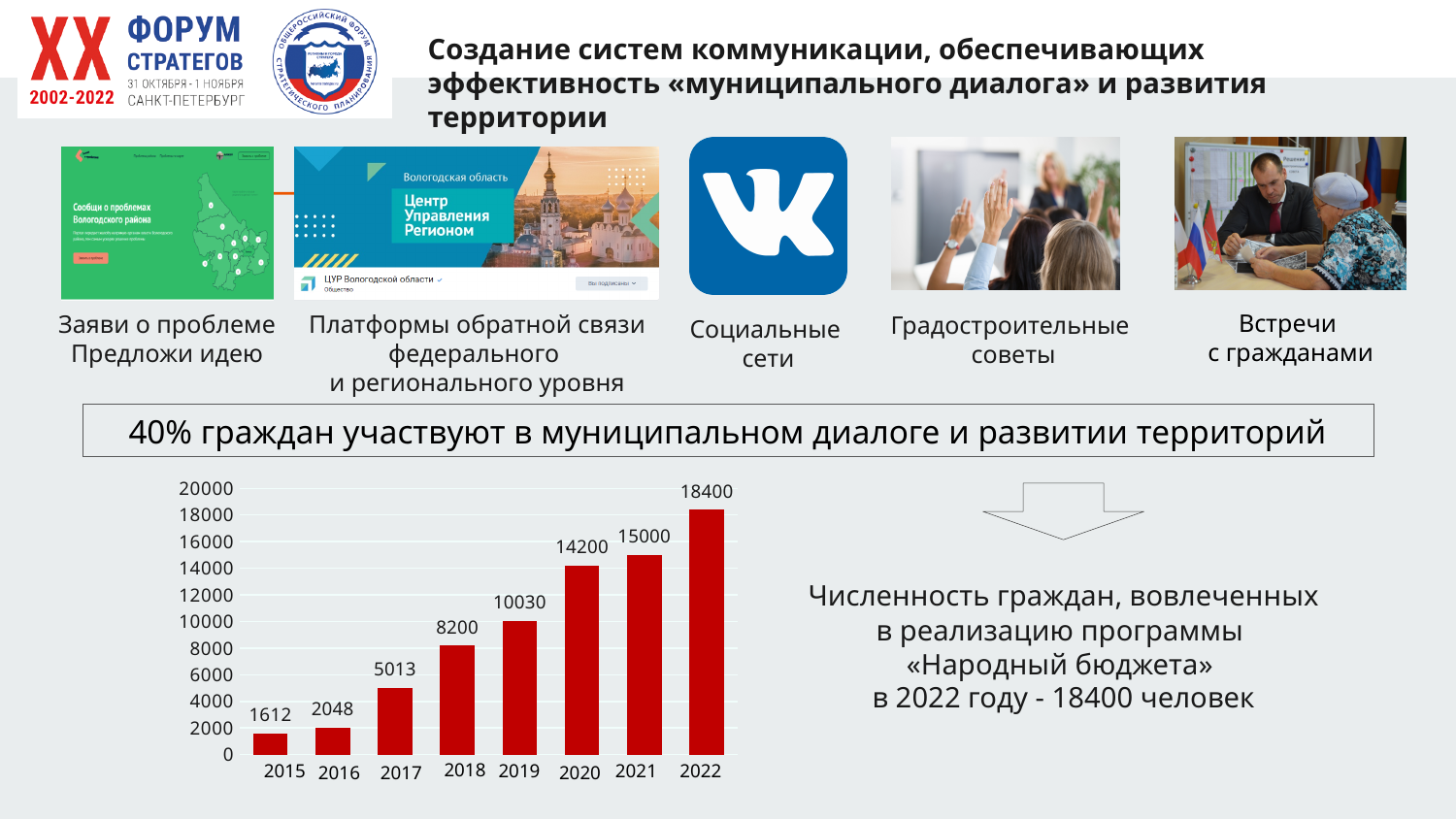
Which year has the lowest value? 2015 Do the values rise or fall from 2015 to 2022? rise What is the difference between the values for 2022 and 2021? 3400 What is the value for 2018? 8200 What is the value for 2021? 15000 What is the value for 2015? 1612 Which year has the highest value? 2022 What is the difference between the values for 2017 and 2016? 2965 What kind of chart is shown on the slide? bar chart How many years are shown on the chart? 8 Is the value for 2019 greater or less than 12000? less Which is larger, the value for 2019 or the value for 2020? 2020